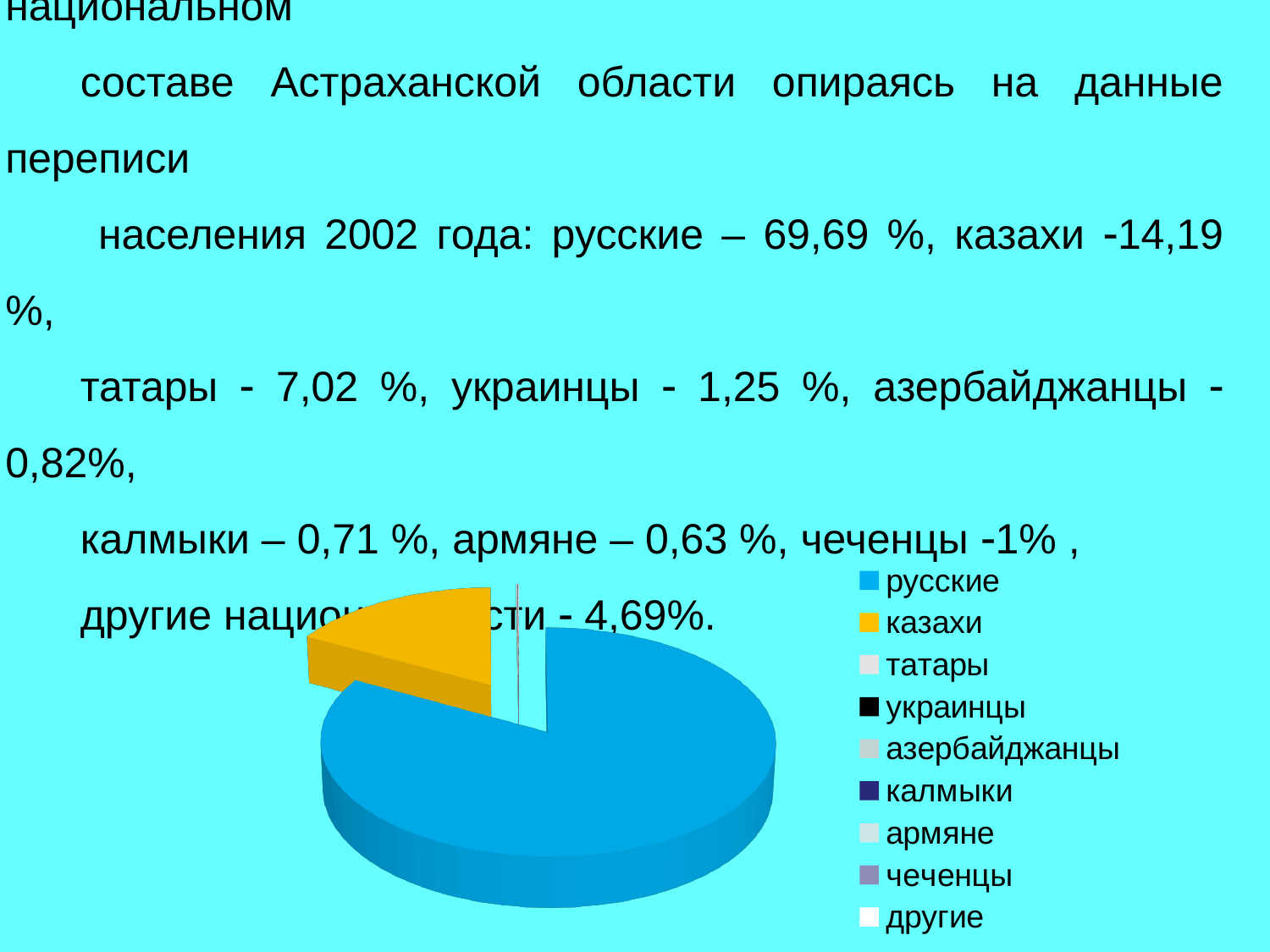
Which category is listed last in the legend? другие Which category has the largest slice of the pie? русские According to the slide, what share of the population is русские? 69,69 % Is the slice for русские greater or less than half of the pie? greater According to the slide, what share of the population is казахи? 14,19 % What colour is the slice for русские? blue What kind of chart is shown on the slide? pie chart Which slice is larger, русские or казахи? русские What colour is the slice for казахи? yellow According to the slide, what share of the population is другие национальности? 4,69% How many categories does the chart's legend list? 9